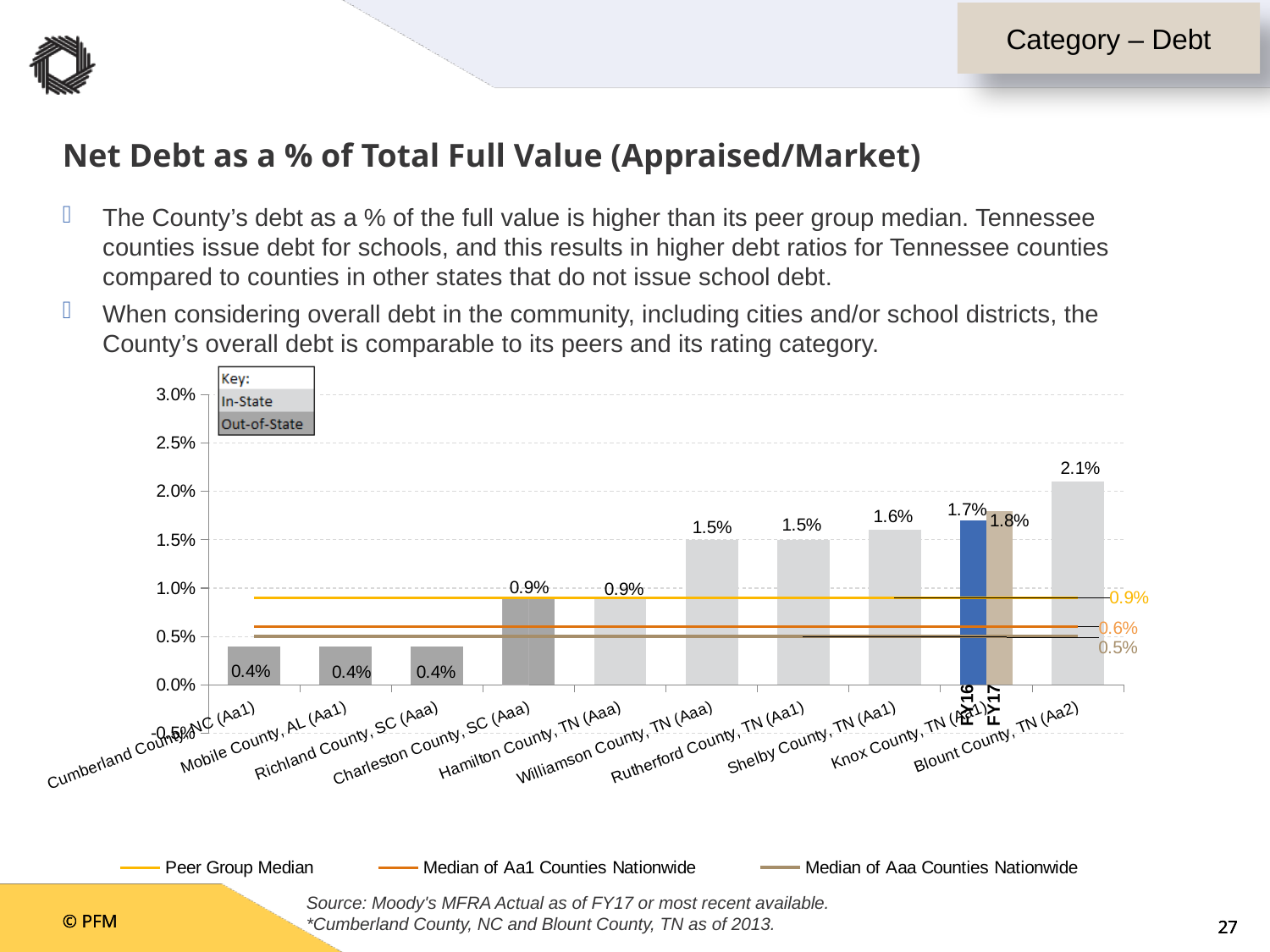
How many counties are shown on the x axis of the chart? 10 What value is shown for the Peer Group Median line? 0.9% Is the value for Rutherford County, TN (Aa1) greater or less than 1.0%? greater Which county has the highest net debt as a % of total full value? Blount County, TN (Aa2) Which has a higher value, Williamson County, TN (Aaa) or Shelby County, TN (Aa1)? Shelby County, TN (Aa1) What is the difference between the values for Blount County, TN (Aa2) and Charleston County, SC (Aaa)? 1.2% What is the title of the chart on the slide? Net Debt as a % of Total Full Value (Appraised/Market) What is the FY17 value shown for Knox County, TN (Aa1)? 1.8% What kind of chart is used to show the county values? Bar chart What is the value shown for Shelby County, TN (Aa1)? 1.6% How many series does the legend at the bottom of the chart list? 3 What is the net debt as a % of total full value for Blount County, TN (Aa2)? 2.1%